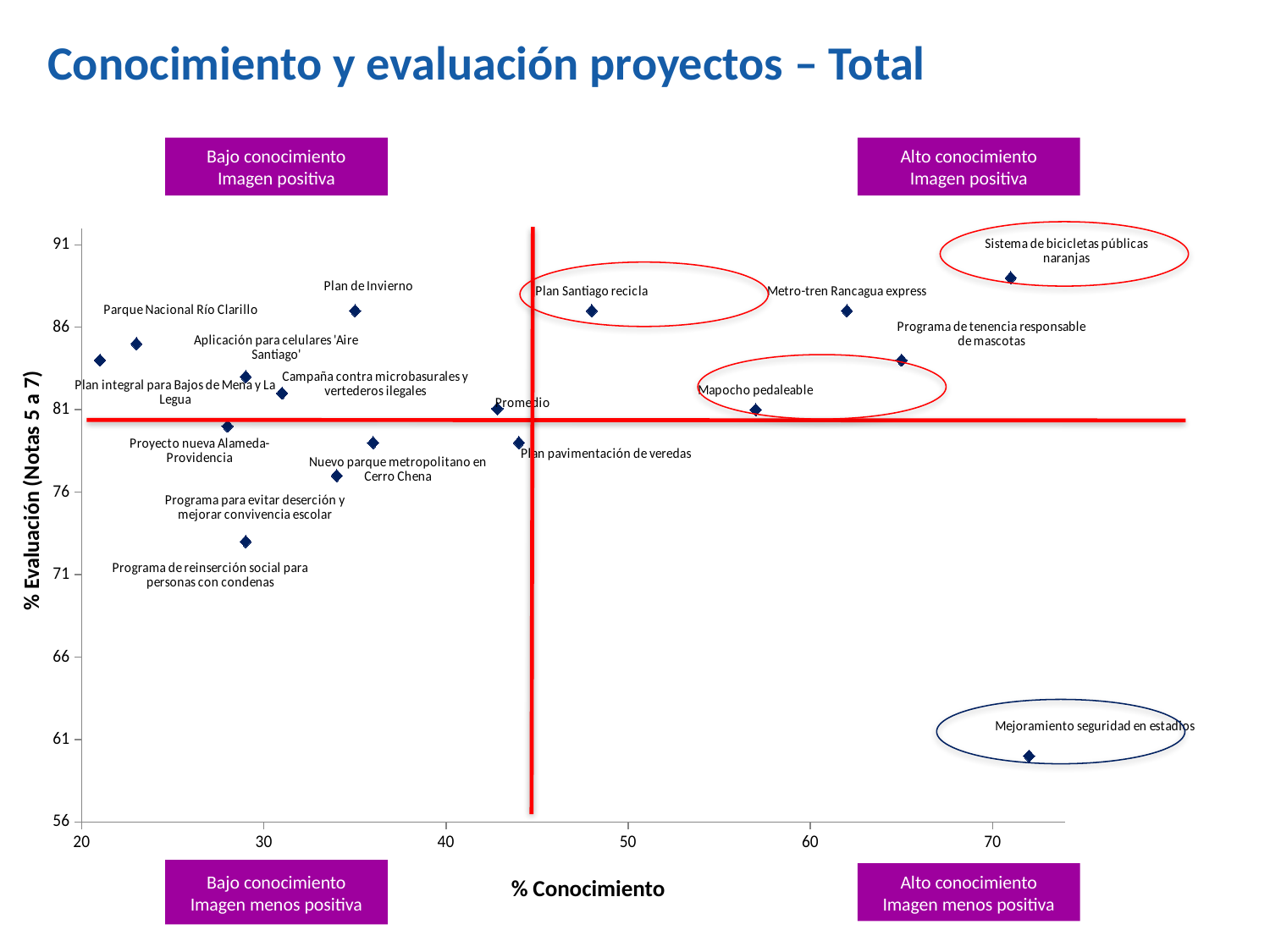
Is the % Evaluación for Plan de Invierno greater or less than 81? greater Is the % Conocimiento for Metro-tren Rancagua express greater or less than 50? greater Is the % Evaluación for Programa de reinserción social para personas con condenas greater or less than 76? less Which project has the highest % Evaluación? Sistema de bicicletas públicas naranjas Which has a higher % Conocimiento, Metro-tren Rancagua express or Parque Nacional Río Clarillo? Metro-tren Rancagua express Which project has the lowest % Evaluación? Mejoramiento seguridad en estadios What is the title of the chart on the slide? Conocimiento y evaluación proyectos – Total What is the label of the horizontal axis? % Conocimiento Which has a higher % Evaluación, Plan de Invierno or Programa de reinserción social para personas con condenas? Plan de Invierno What kind of chart is shown on the slide? Scatter chart